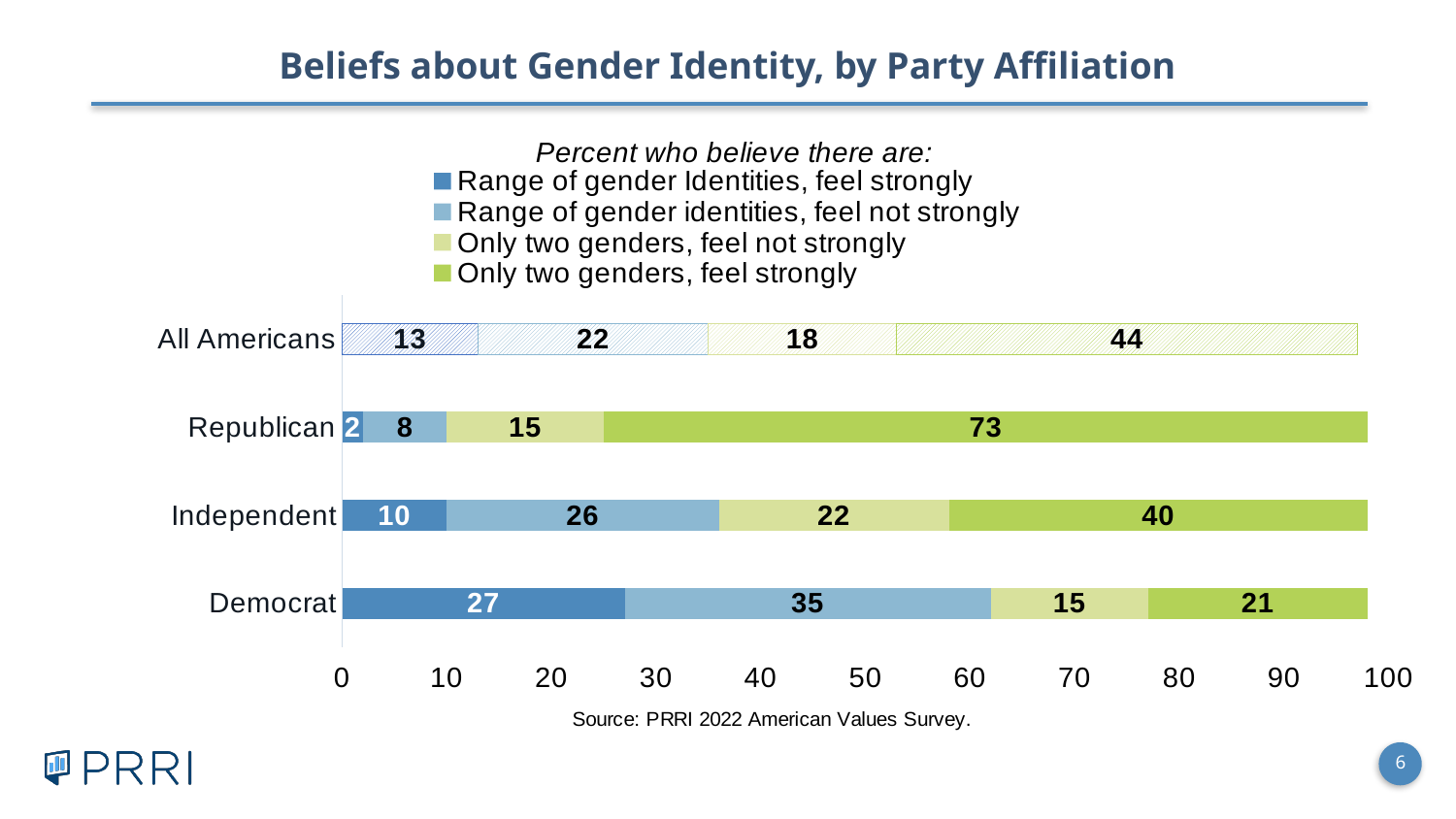
Which category has the lowest value for 'Range of gender identities, feel strongly'? Republican What percentage of Democrats believe there is a range of gender identities and feel strongly about it? 27 What is the title of the chart on the slide? Percent who believe there are: Which category has the highest value for 'Only two genders, feel strongly'? Republican How many categories (groups) are shown on the chart? 4 What is the value for All Americans in the 'Only two genders, feel not strongly' series? 18 What is the difference between the Republican and Democrat values for 'Only two genders, feel strongly'? 52 Which is larger for 'Range of gender identities, feel not strongly': Independent or Democrat? Democrat How many series does the legend list? 4 What is the total of the four segments in the Democrat bar? 98 What kind of chart is shown on the slide? Stacked bar chart What percentage of Republicans believe there are only two genders and feel strongly about it? 73